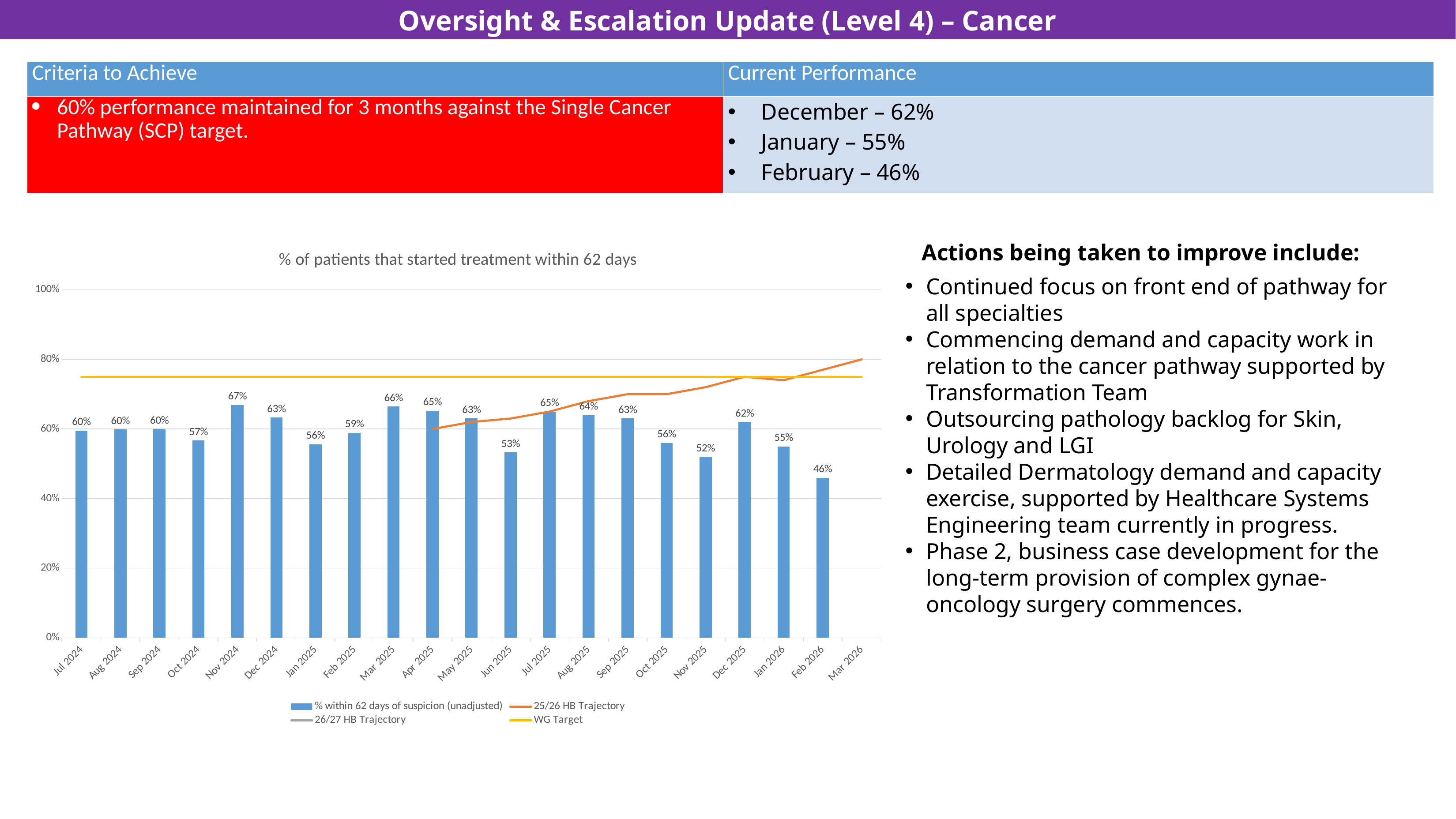
Which month has the lowest bar value? Feb 2026 What is the value for Nov 2024? 67% Is the WG Target line greater or less than 60%? greater Which is larger, the value for Mar 2025 or the value for Oct 2025? Mar 2025 What is the title of the chart? % of patients that started treatment within 62 days How many series does the legend list? 4 What is the difference between the values for Dec 2025 and Jan 2026? 7% What type of chart is used to show the % within 62 days of suspicion (unadjusted) values? Bar chart What is the value for Jun 2025? 53% What is the value for Feb 2026? 46% Which month has the highest bar value? Nov 2024 How many months are labelled on the x axis? 21